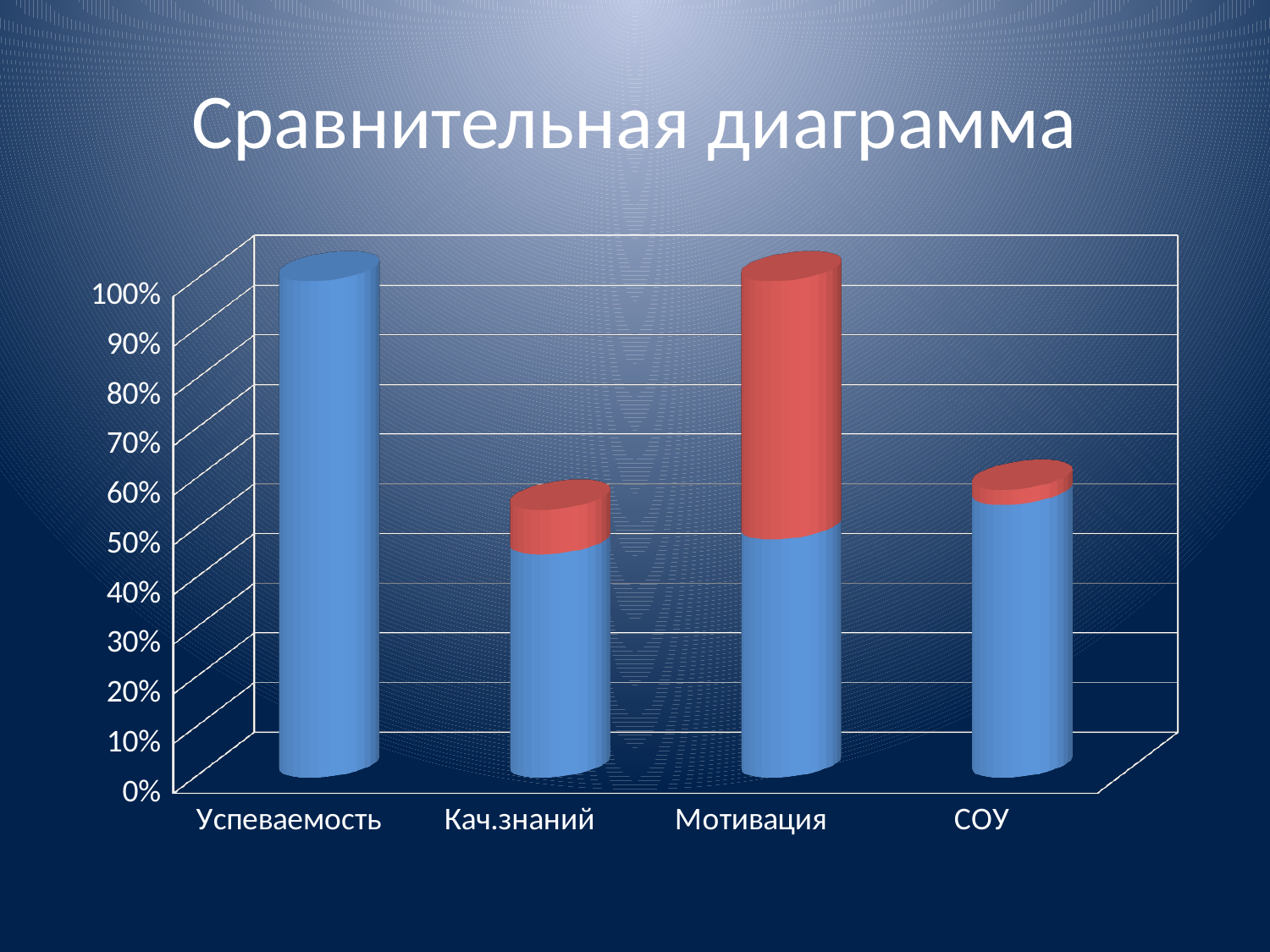
Which is larger, the bar for Успеваемость or the bar for Кач.знаний? Успеваемость What is the title of the chart on the slide? Сравнительная диаграмма Which is larger, the bar for Мотивация or the bar for СОУ? Мотивация Is the blue segment of the Мотивация bar greater or less than 40%? greater Is the total value for Мотивация greater or less than 80%? greater Is the total value for Кач.знаний greater or less than 70%? less Which category's bar has no red segment? Успеваемость What kind of chart is shown on the slide? bar chart How many categories are shown on the x axis of the chart? 4